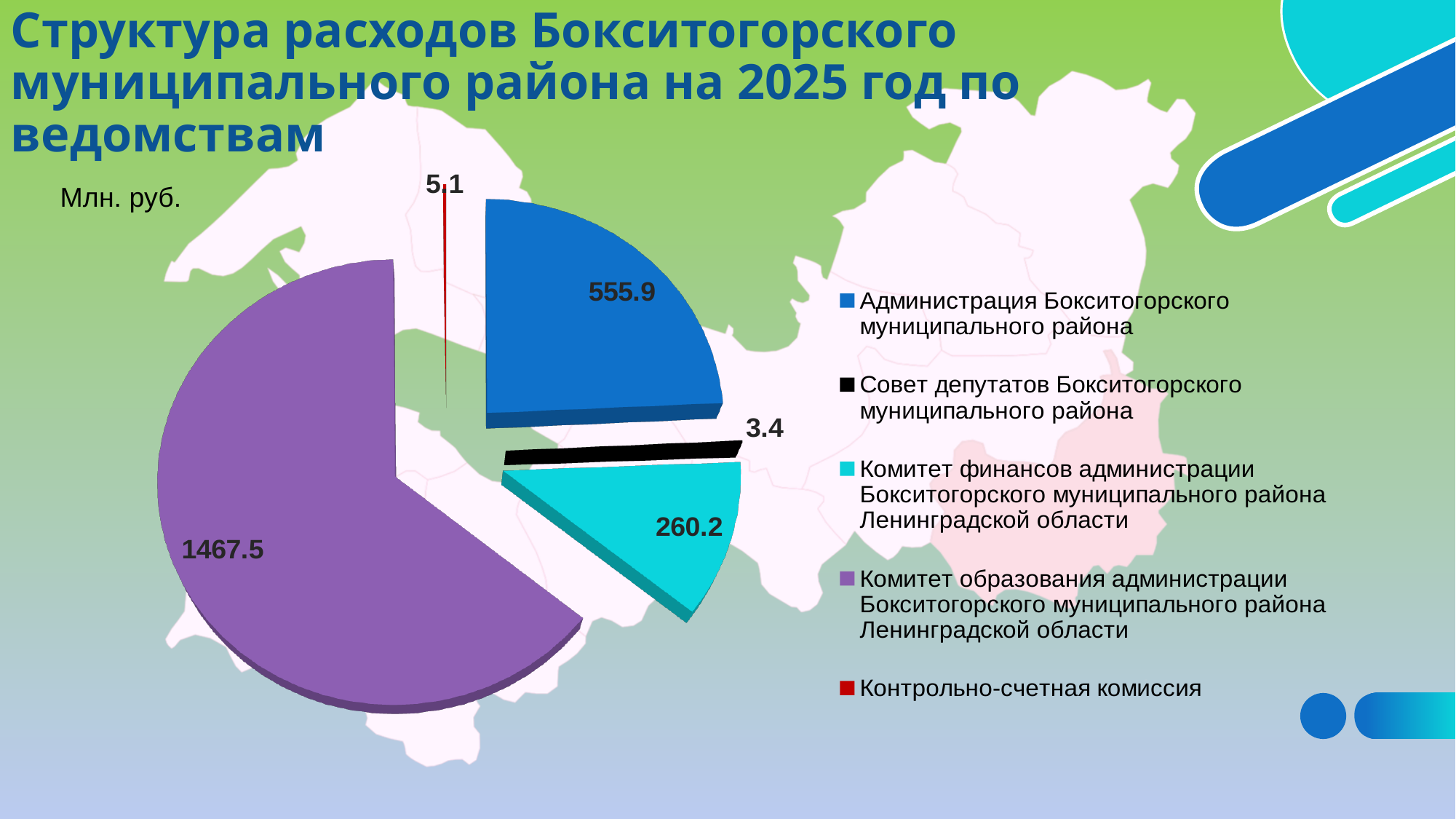
Which is larger: the value for Администрация Бокситогорского муниципального района or for Комитет финансов? Администрация Бокситогорского муниципального района What type of chart is shown on the slide? Pie chart What is the value for Комитет образования администрации Бокситогорского муниципального района Ленинградской области? 1467.5 How many categories does the legend list? 5 What is the value for Комитет финансов администрации Бокситогорского муниципального района Ленинградской области? 260.2 What is the value for Контрольно-счетная комиссия? 5.1 What is the value for Совет депутатов Бокситогорского муниципального района? 3.4 What is the value for Администрация Бокситогорского муниципального района? 555.9 What is the difference between the values for Комитет образования and Администрация Бокситогорского муниципального района? 911.6 In what units are the values on the chart given? Млн. руб. Which category has the largest slice of the pie? Комитет образования администрации Бокситогорского муниципального района Ленинградской области Which category has the smallest value? Совет депутатов Бокситогорского муниципального района